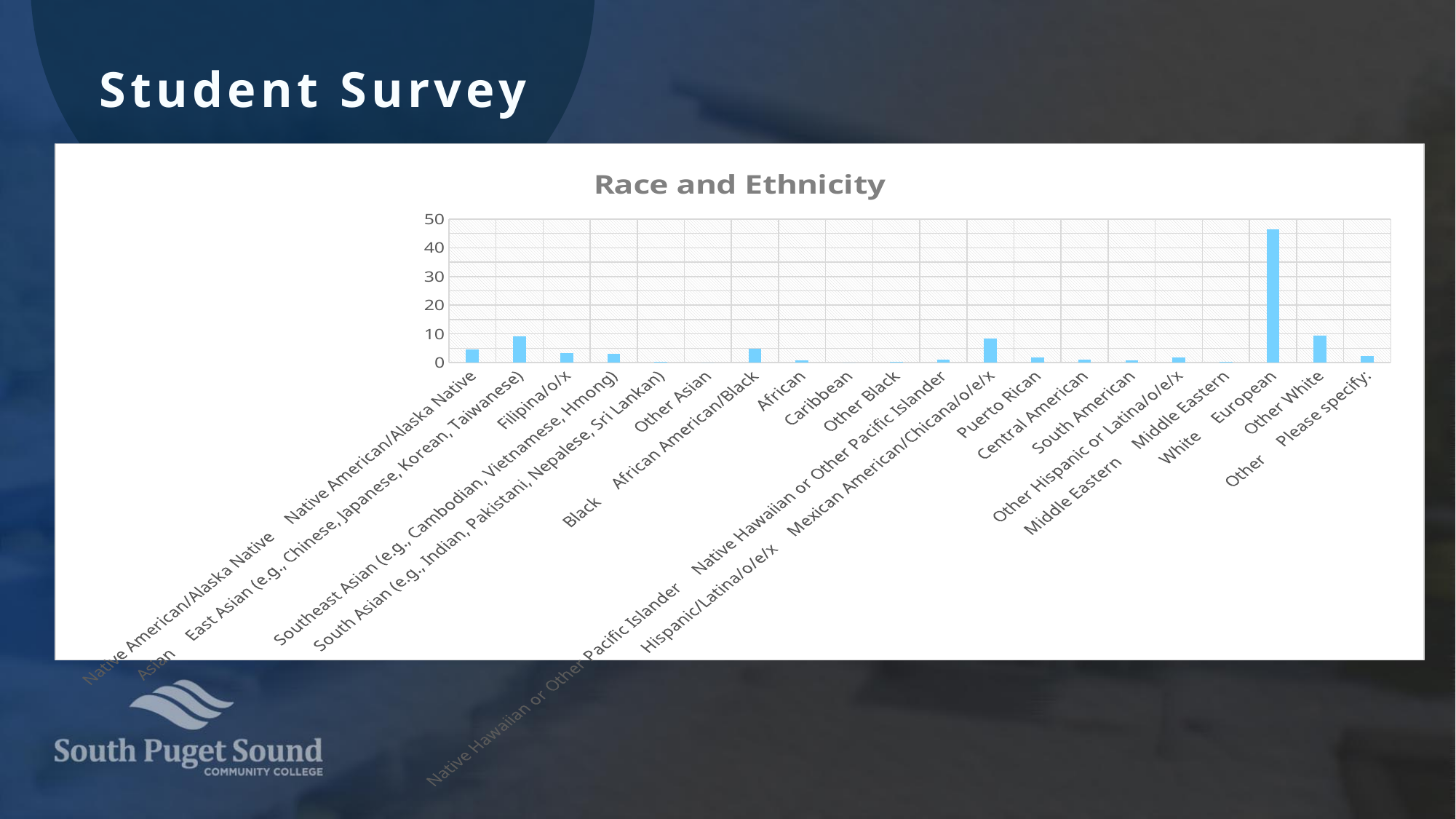
Is the value for Hispanic/Latina/o/e/x (Mexican American/Chicana/o/e/x) greater or less than 10? less Which is larger, the value for Hispanic/Latina/o/e/x (Mexican American/Chicana/o/e/x) or the value for Puerto Rican? Hispanic/Latina/o/e/x (Mexican American/Chicana/o/e/x) What is the title of the chart? Race and Ethnicity What kind of chart is shown on the slide? bar chart Is the value for White (European) greater or less than 40? greater Which is larger, the value for White (European) or the value for Other White? White (European) Which is larger, the value for Asian (East Asian) or the value for Filipina/o/x? Asian (East Asian) How many categories are shown on the x axis of the chart? 20 Is the value for Native American/Alaska Native greater or less than 10? less What is the highest value shown on the y axis of the chart? 50 Which category has the highest value in the Race and Ethnicity chart? White (European)